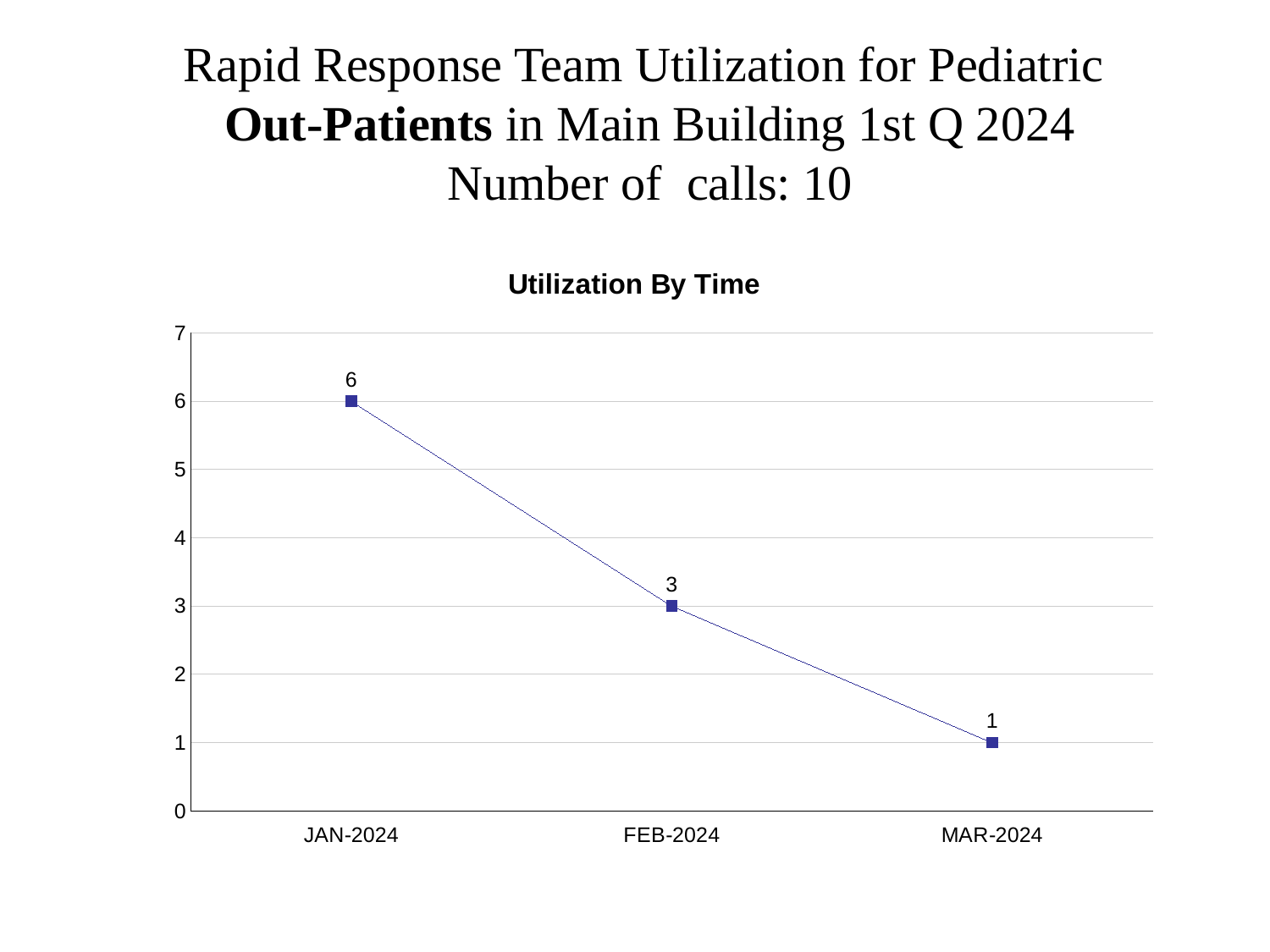
What is the value for MAR-2024? 1 What is the value for JAN-2024? 6 What is the difference between the values for FEB-2024 and MAR-2024? 2 What is the difference between the values for JAN-2024 and FEB-2024? 3 What is the value for FEB-2024? 3 Which month has the highest value? JAN-2024 What kind of chart is shown? line chart Do the values rise or fall from JAN-2024 to MAR-2024? fall How many months are plotted on the chart? 3 Which is larger, the value for JAN-2024 or the value for MAR-2024? JAN-2024 Which month has the lowest value? MAR-2024 What is the title of the chart? Utilization By Time